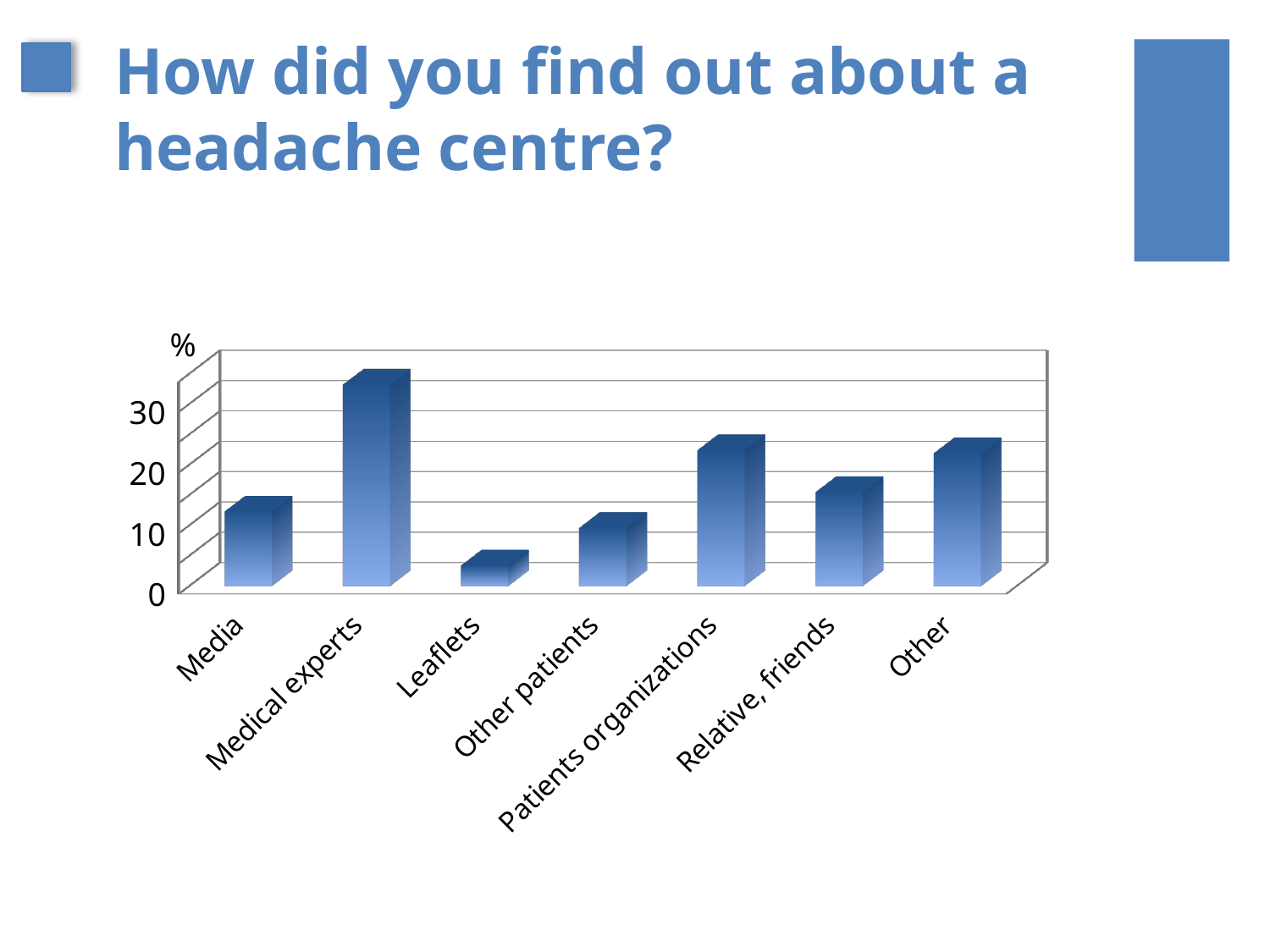
Is the value for Leaflets greater or less than 10? less Is the value for Relative, friends greater or less than 20? less Which category has the highest value in the chart? Medical experts Is the value for Medical experts greater or less than 30? greater Which is larger, the value for Relative, friends or the value for Leaflets? Relative, friends Which is larger, the value for Medical experts or the value for Media? Medical experts What kind of chart is shown on the slide? bar chart What unit is shown on the vertical axis of the chart? % Which category has the lowest value in the chart? Leaflets How many categories are shown on the x axis of the chart? 7